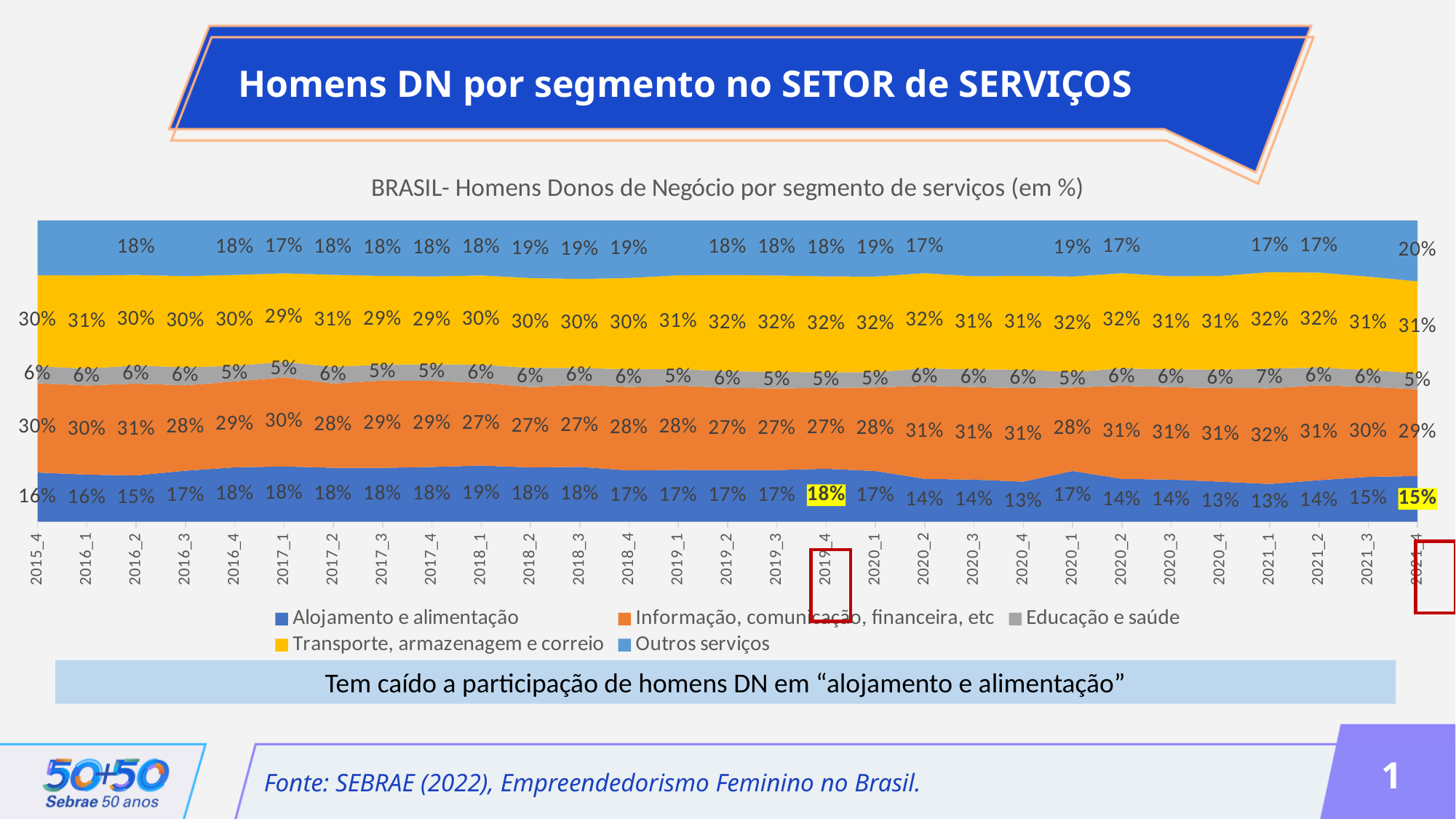
In which quarter does Outros serviços reach its highest value? 2021_4 What is the value for Informação, comunicação, financeira, etc in 2021_4? 29% What is the value for Educação e saúde in 2021_4? 5% What is the value for Alojamento e alimentação in 2019_4? 18% How many series does the legend list? 5 What is the value for Alojamento e alimentação in 2021_4? 15% By how many percentage points did Alojamento e alimentação change between 2019_4 and 2021_4? 3 percentage points What is the value for Outros serviços in 2021_4? 20% What is the title of the chart? BRASIL- Homens Donos de Negócio por segmento de serviços (em %) In 2021_4, which is larger: Transporte, armazenagem e correio or Informação, comunicação, financeira, etc? Transporte, armazenagem e correio What kind of chart is shown on the slide? stacked area chart What is the value for Transporte, armazenagem e correio in 2015_4? 30%